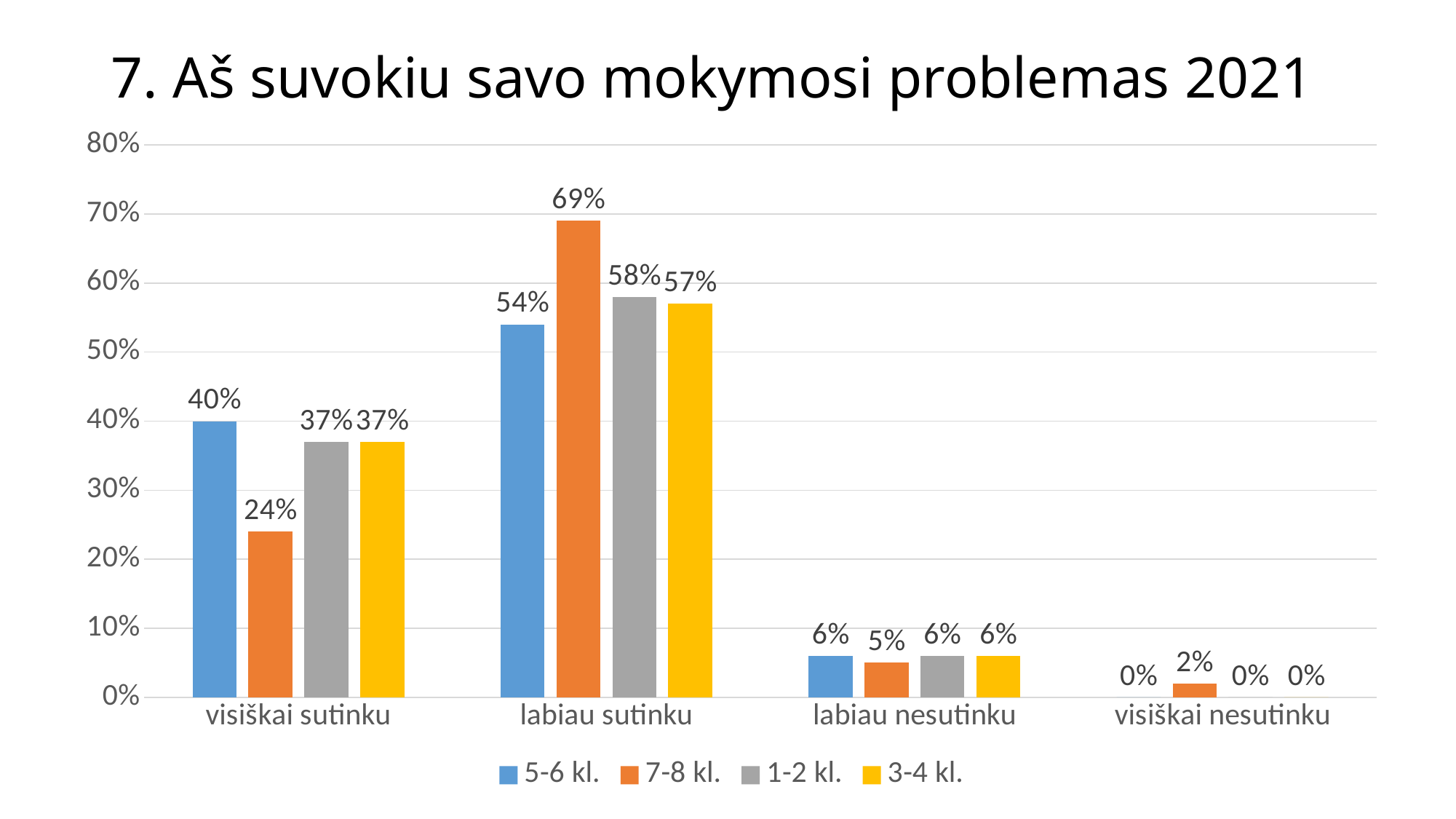
What is the value for 5-6 kl. in the visiškai sutinku category? 40% How many series does the legend list? 4 Which series has the lowest value in the visiškai sutinku category? 7-8 kl. What is the value for 1-2 kl. in the labiau nesutinku category? 6% What is the difference between the 5-6 kl. and 7-8 kl. values in the visiškai sutinku category? 16% What is the difference between the 7-8 kl. and 5-6 kl. values in the labiau sutinku category? 15% How many categories are shown on the x axis? 4 Which series has the highest value in the labiau sutinku category? 7-8 kl. Which is larger: the 1-2 kl. value for labiau sutinku or the 3-4 kl. value for visiškai sutinku? 1-2 kl. value for labiau sutinku What is the value for 7-8 kl. in the visiškai nesutinku category? 2% What kind of chart is shown on the slide? Bar chart What is the value for 7-8 kl. in the labiau sutinku category? 69%